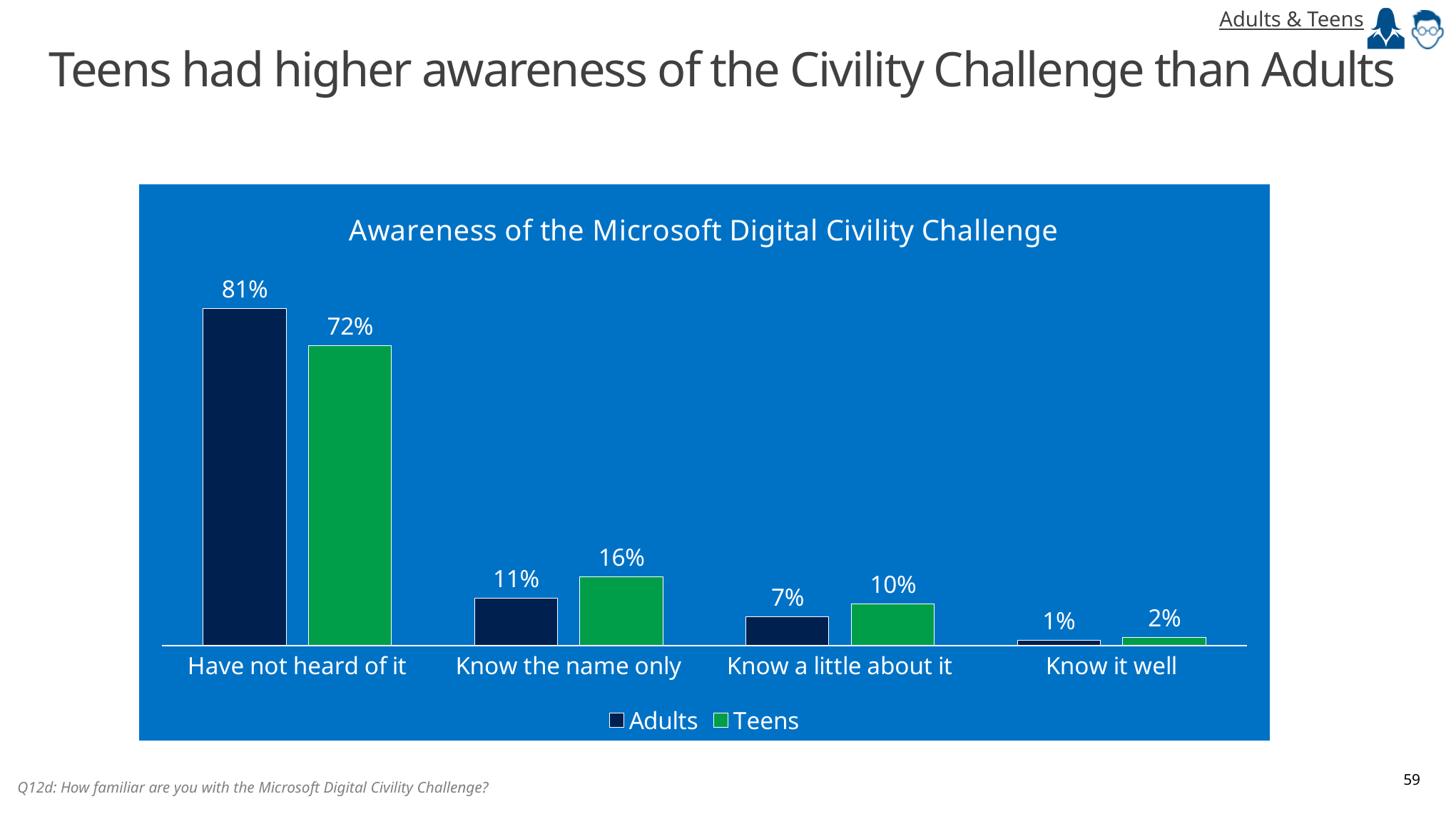
What is the value for Teens in the 'Know a little about it' category? 10% What kind of chart is shown on the slide? Bar chart Which category has the highest value for Teens? Have not heard of it What percentage of Teens know the name only? 16% How many categories are shown on the x axis? 4 What is the difference between Adults and Teens in the 'Have not heard of it' category? 9% Which is larger in the 'Know the name only' category, Adults or Teens? Teens What is the title of the chart? Awareness of the Microsoft Digital Civility Challenge What is the value for Adults in the 'Know it well' category? 1% Which category has the lowest value for Adults? Know it well What percentage of Adults have not heard of the Microsoft Digital Civility Challenge? 81% How many series does the legend list? 2